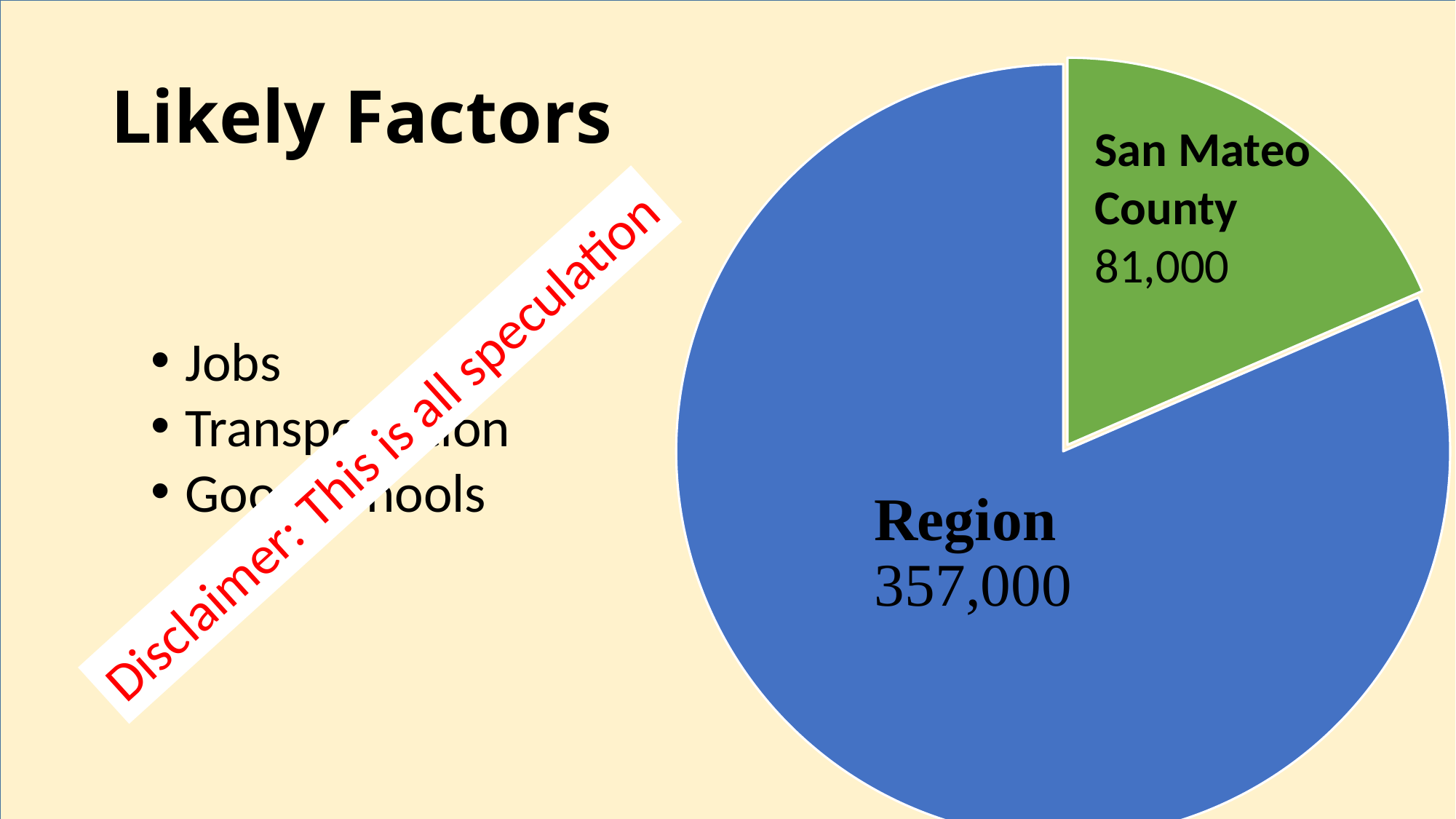
Which slice of the pie chart has the smallest value? San Mateo County What is the difference between the Region value and the San Mateo County value in the pie chart? 276,000 What colour is the Region slice in the pie chart? Blue What kind of chart is shown on the slide? Pie chart What is the total of the two values shown in the pie chart? 438,000 Which slice of the pie chart has the largest value? Region What is the value shown for San Mateo County in the pie chart? 81,000 Which is larger in the pie chart, Region or San Mateo County? Region What is the value shown for Region in the pie chart? 357,000 How many slices does the pie chart have? 2 What colour is the San Mateo County slice in the pie chart? Green